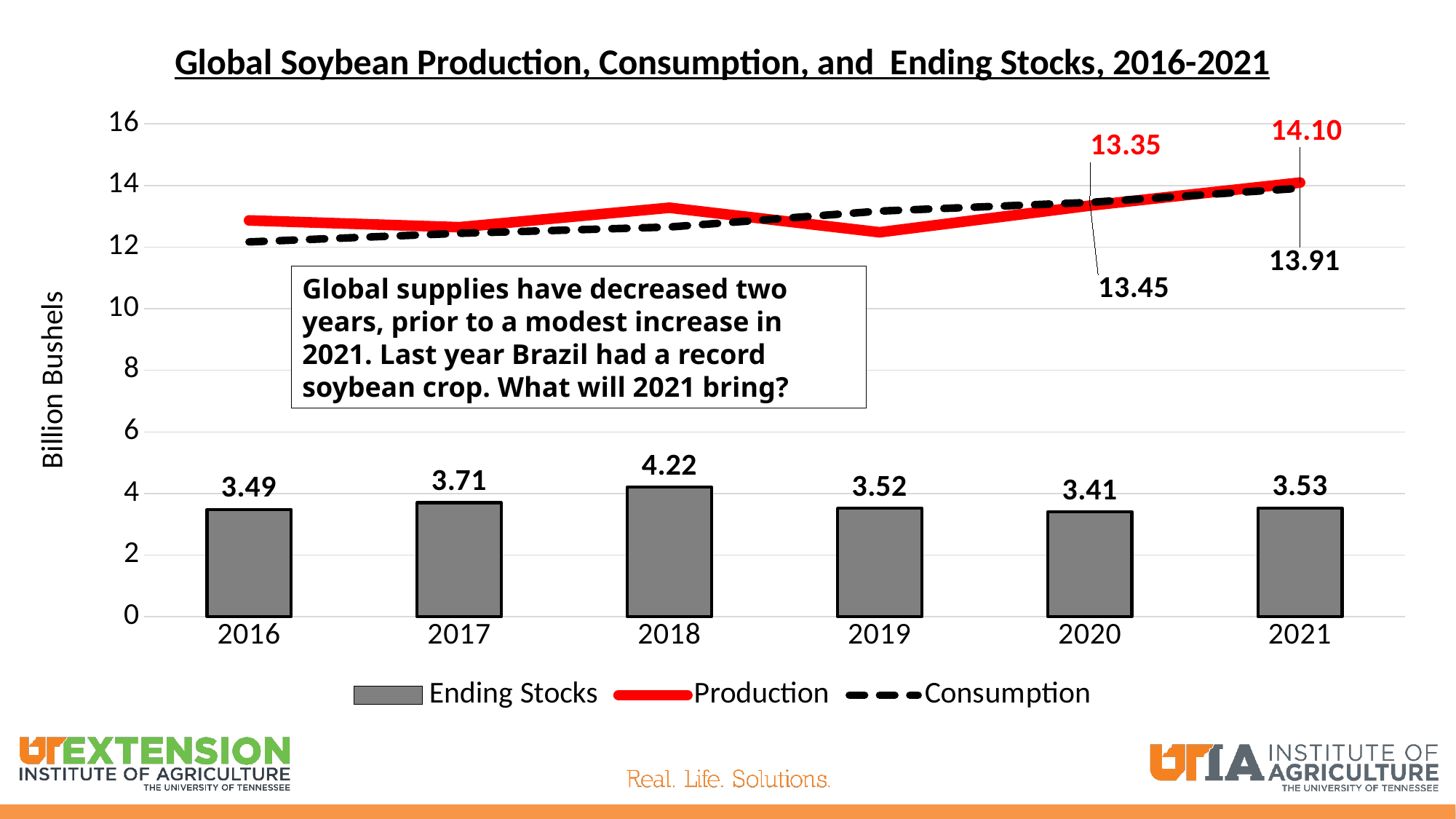
What is the Consumption value for 2020? 13.45 What is the difference between Ending Stocks in 2018 and 2020? 0.81 In 2020, which is larger, Production or Consumption? Consumption What is the Production value for 2021? 14.10 By how much did Production increase from 2020 to 2021? 0.75 How many years are shown on the x axis? 6 How many series does the legend list? 3 Is the Production value for 2019 greater or less than 14? less What is the value of Ending Stocks for 2018? 4.22 Which year has the highest Ending Stocks? 2018 What is the label on the y axis? Billion Bushels Which year has the lowest Ending Stocks? 2020